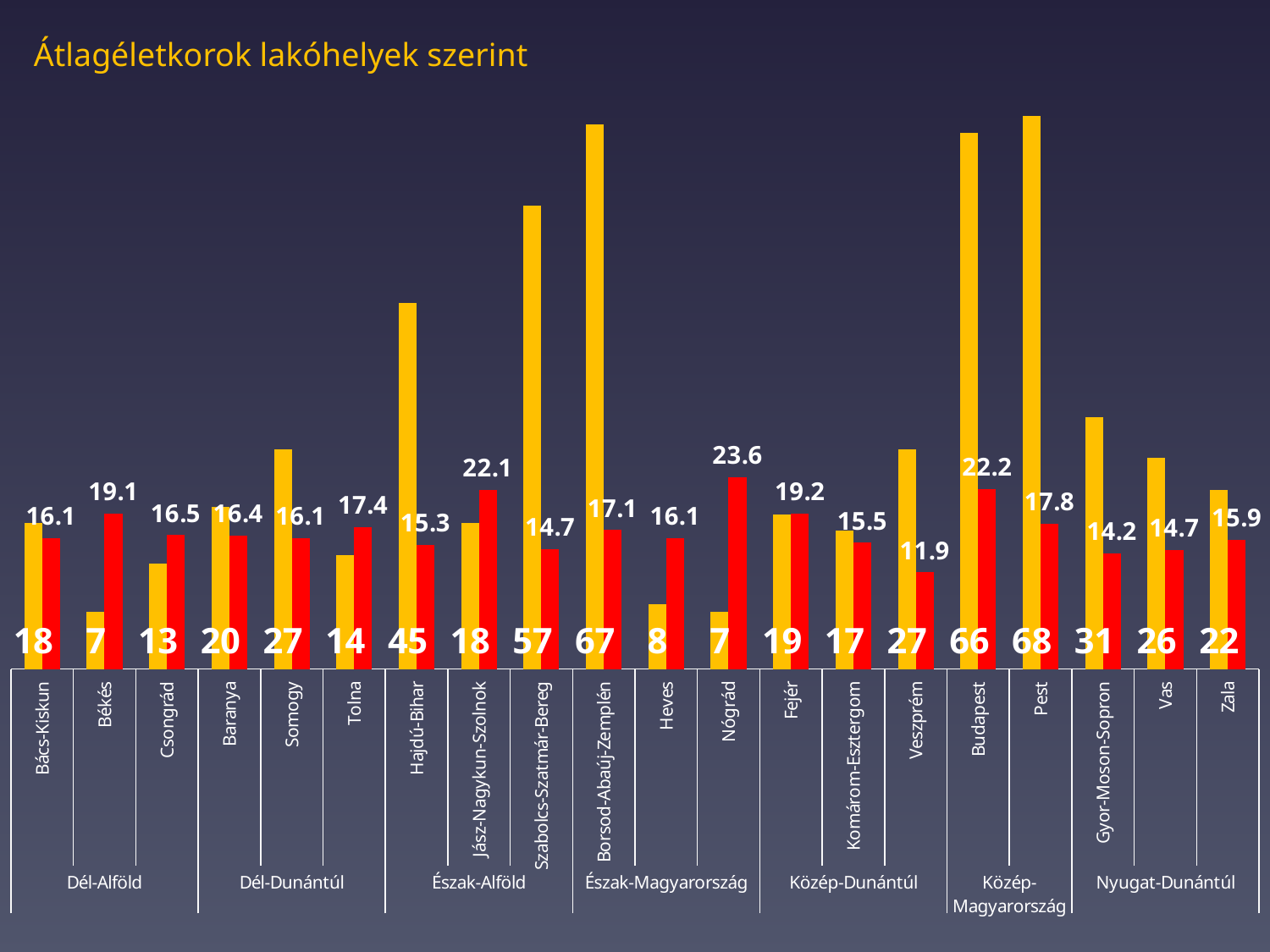
What is the value shown on the yellow bar for Pest? 68 What is the value shown on the red bar for Veszprém? 11.9 What is the difference between the yellow bar values for Pest and Budapest? 2 Which category has the lowest red bar? Veszprém What is the value shown on the yellow bar for Szabolcs-Szatmár-Bereg? 57 Which category has the highest yellow bar? Pest Which has a larger yellow bar value, Hajdú-Bihar or Gyor-Moson-Sopron? Hajdú-Bihar What kind of chart is shown on the slide? Bar chart Which category has the highest red bar? Nógrád How many categories (counties) are shown on the x axis? 20 What is the difference between the red bar values for Nógrád and Veszprém? 11.7 What is the value shown on the red bar for Nógrád? 23.6